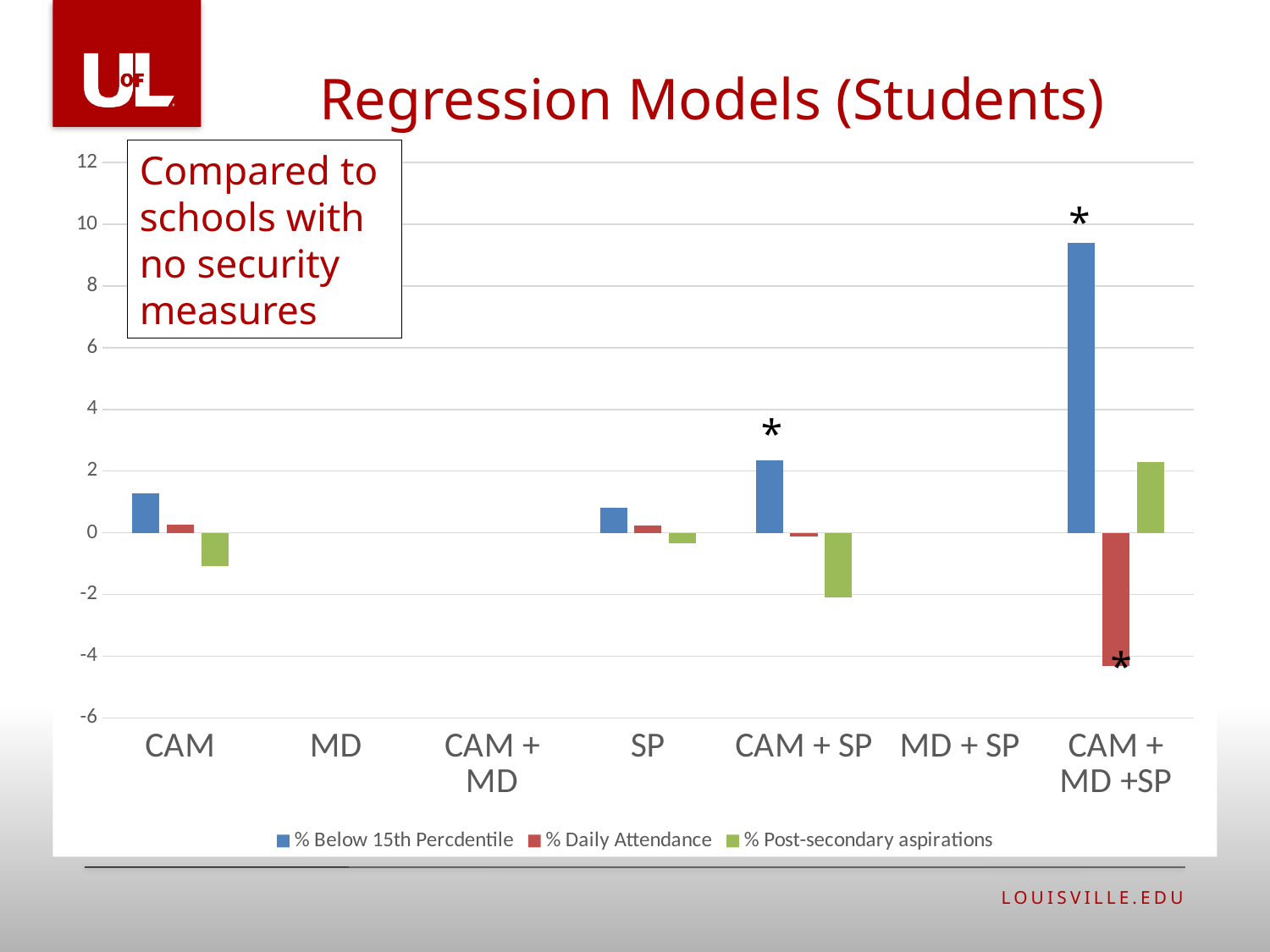
Which is larger, the % Below 15th Percdentile value for CAM + SP or for CAM? CAM + SP How many categories are shown on the x axis? 7 What kind of chart is shown on the slide? bar chart Which category has the highest value for % Below 15th Percdentile? CAM + MD +SP Is the value for % Below 15th Percdentile at CAM + MD +SP greater or less than 8? greater How many series does the legend list? 3 Which is larger, the % Post-secondary aspirations value for CAM + MD +SP or for SP? CAM + MD +SP Is the value for % Post-secondary aspirations at CAM + SP greater or less than 0? less Is the value for % Daily Attendance at CAM + MD +SP greater or less than -2? less Which series is shown in blue in the legend? % Below 15th Percdentile What is the title of the chart? Regression Models (Students) Which category has the lowest value for % Daily Attendance? CAM + MD +SP